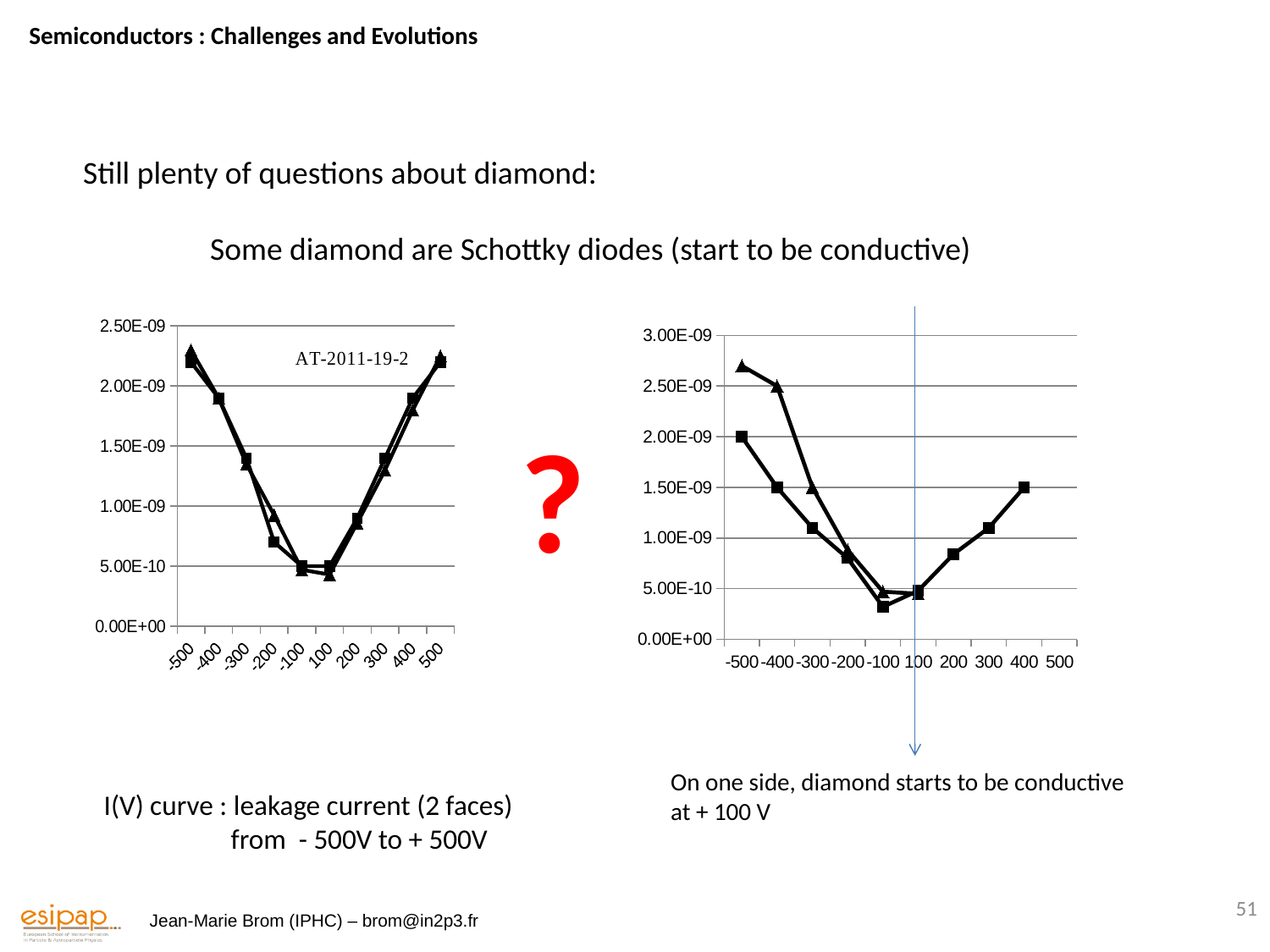
How many voltage values are labelled on the x axis of the right chart? 10 What kind of chart is the left chart (AT-2011-19-2)? line chart In the left chart, is the square-marker value at -100 greater or less than 1.00E-09? less In the right chart, do the values rise or fall as the voltage goes from -500 to -100? fall In the right chart, at -500, which series has the larger value: the triangle-marker series or the square-marker series? triangle-marker series What is the highest tick value on the y axis of the right chart? 3.00E-09 In the right chart, is the triangle-marker value at -500 greater or less than 2.50E-09? greater In the left chart, is the square-marker value at -500 greater or less than 2.00E-09? greater How many voltage values are labelled on the x axis of the left chart? 10 What kind of chart is the right chart? line chart What label is printed inside the plot area of the left chart? AT-2011-19-2